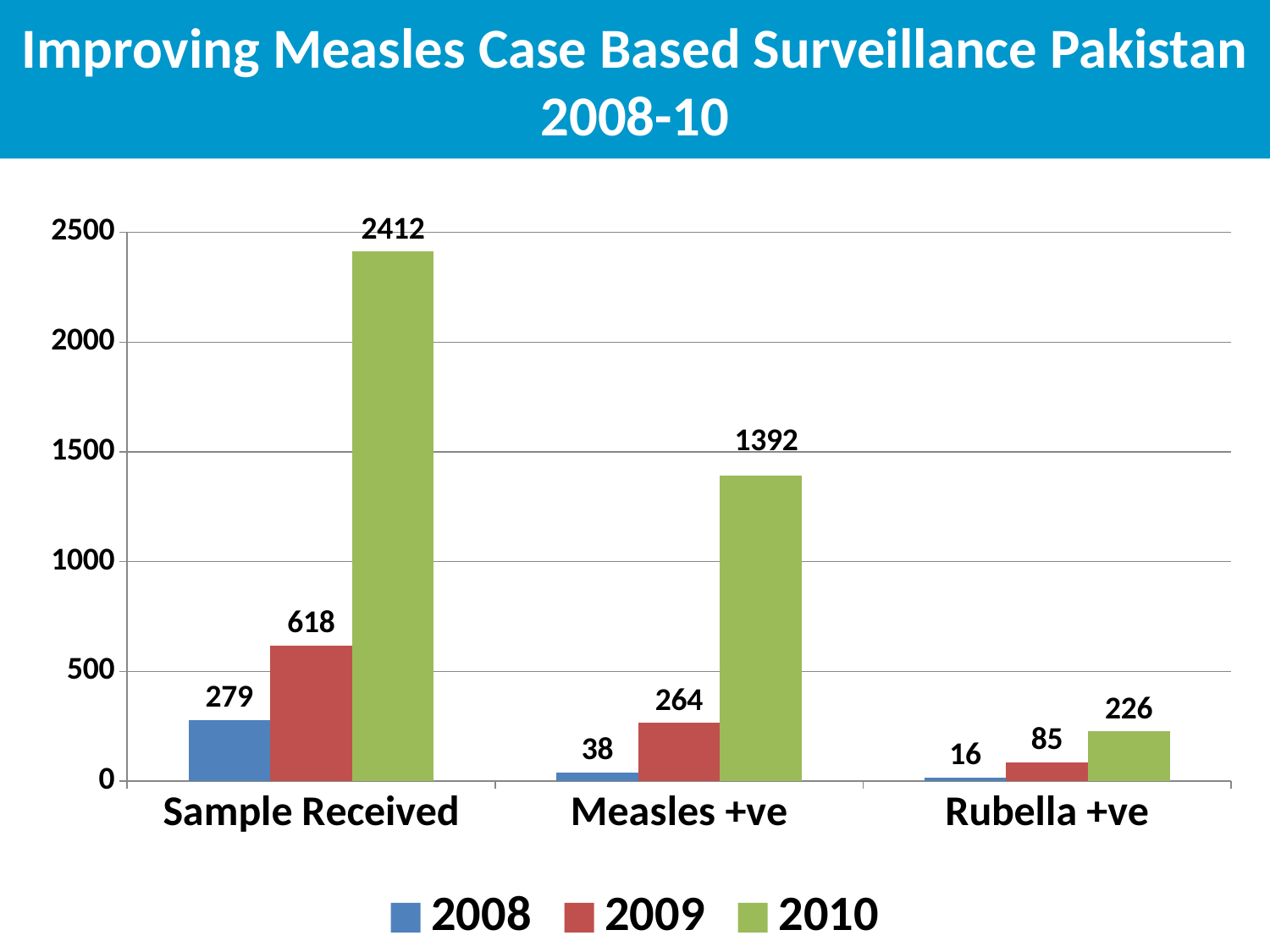
How many categories are shown on the x axis? 3 What is the value for Rubella +ve in 2008? 16 Which category has the lowest value for 2008? Rubella +ve How many series does the legend list? 3 What is the difference between samples received in 2010 and 2009? 1794 What kind of chart is shown on the slide? Bar chart Which category has the highest value for 2010? Sample Received What is the difference between Measles +ve cases in 2009 and 2008? 226 Which is larger: Measles +ve in 2010 or Sample Received in 2009? Measles +ve in 2010 What was the number of samples received in 2010? 2412 Which colour represents the year 2009 in the chart? Red How many Measles +ve cases were there in 2009? 264